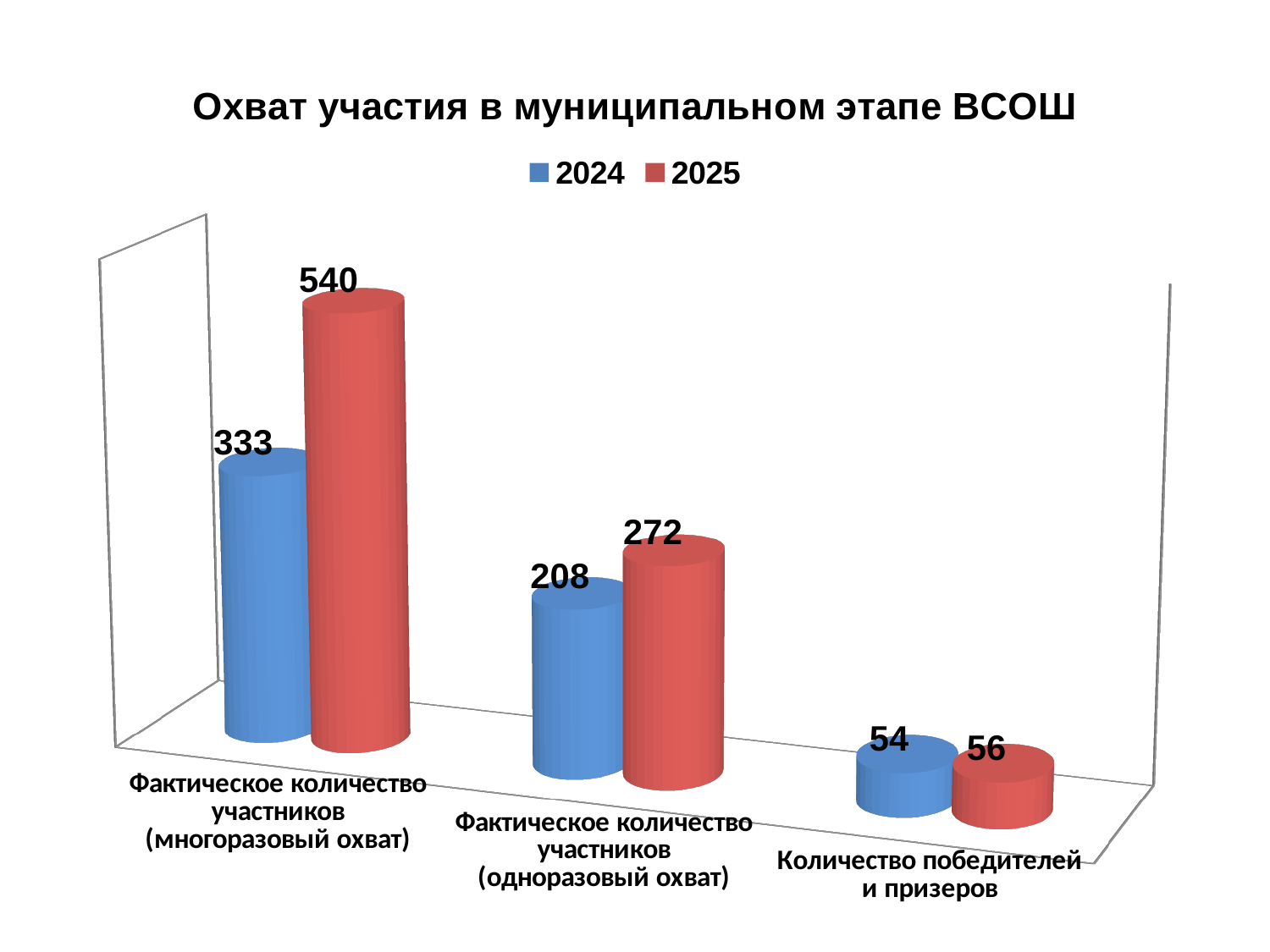
What kind of chart is shown on the slide? Bar chart Which category has the lowest 2024 value? Количество победителей и призеров How many series does the legend list? 2 What is the 2025 value for 'Количество победителей и призеров'? 56 What is the 2025 value for 'Фактическое количество участников (одноразовый охват)'? 272 What is the difference between the 2025 and 2024 values for 'Фактическое количество участников (многоразовый охват)'? 207 What is the difference between the 2025 and 2024 values for 'Фактическое количество участников (одноразовый охват)'? 64 What is the title of the chart? Охват участия в муниципальном этапе ВСОШ Which category has the highest 2025 value? Фактическое количество участников (многоразовый охват) What is the 2024 value for 'Фактическое количество участников (многоразовый охват)'? 333 How many categories are shown on the x axis? 3 Which is larger for 'Количество победителей и призеров': the 2024 value or the 2025 value? 2025